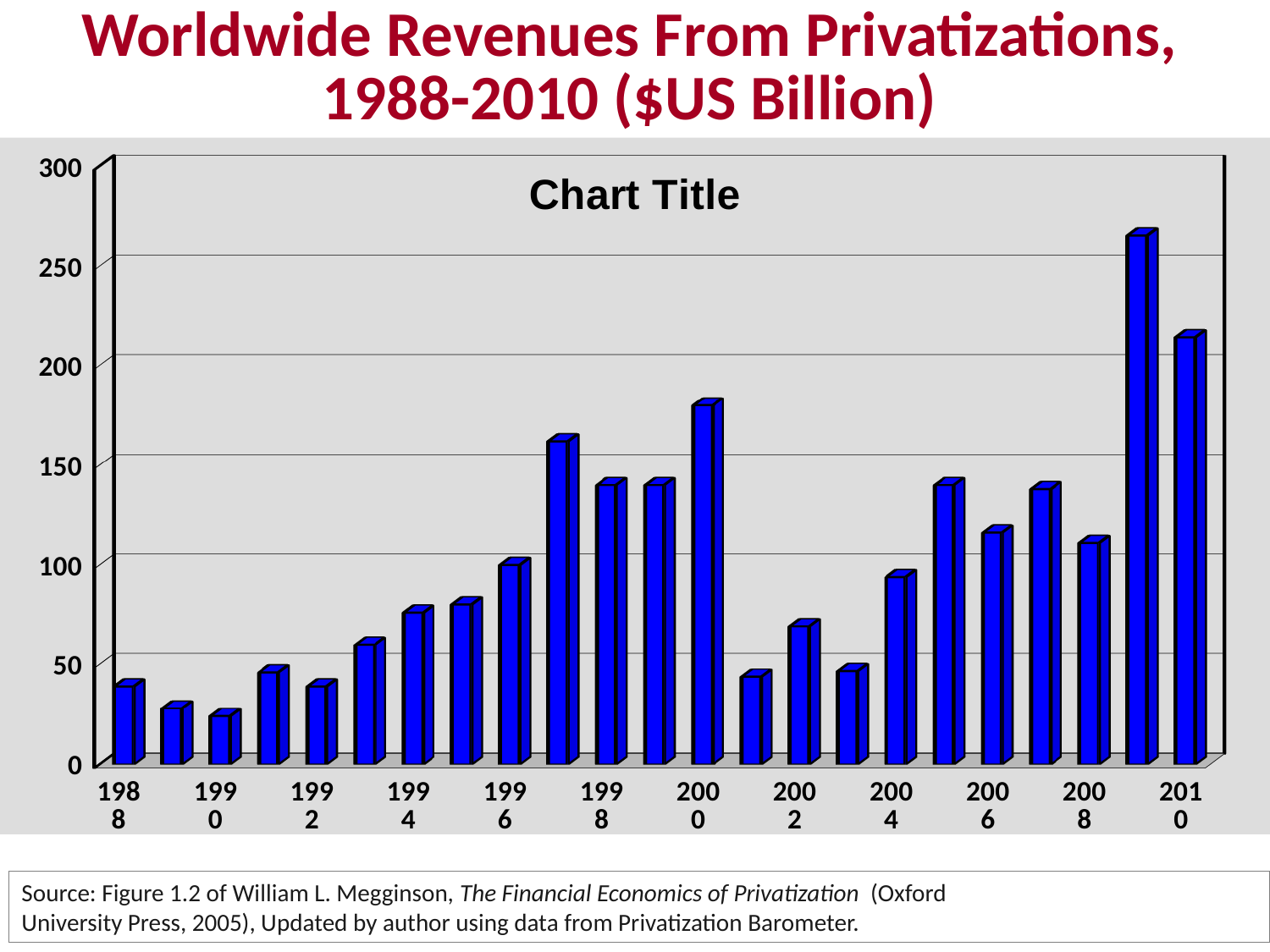
Which is larger, the value for 2004 or the value for 2002? 2004 What kind of chart is shown on the slide? bar chart Among the years labeled on the x axis, which has the lowest bar? 1990 Is the value for 1990 greater or less than 50? less Is the value for 2010 greater or less than 200? greater Which is larger, the value for 2000 or the value for 1998? 2000 Is the value for 2002 greater or less than 50? greater What colour are the bars in the chart? blue How many bars are plotted in the chart? 23 Do the values generally rise or fall from 1990 to 2000? rise